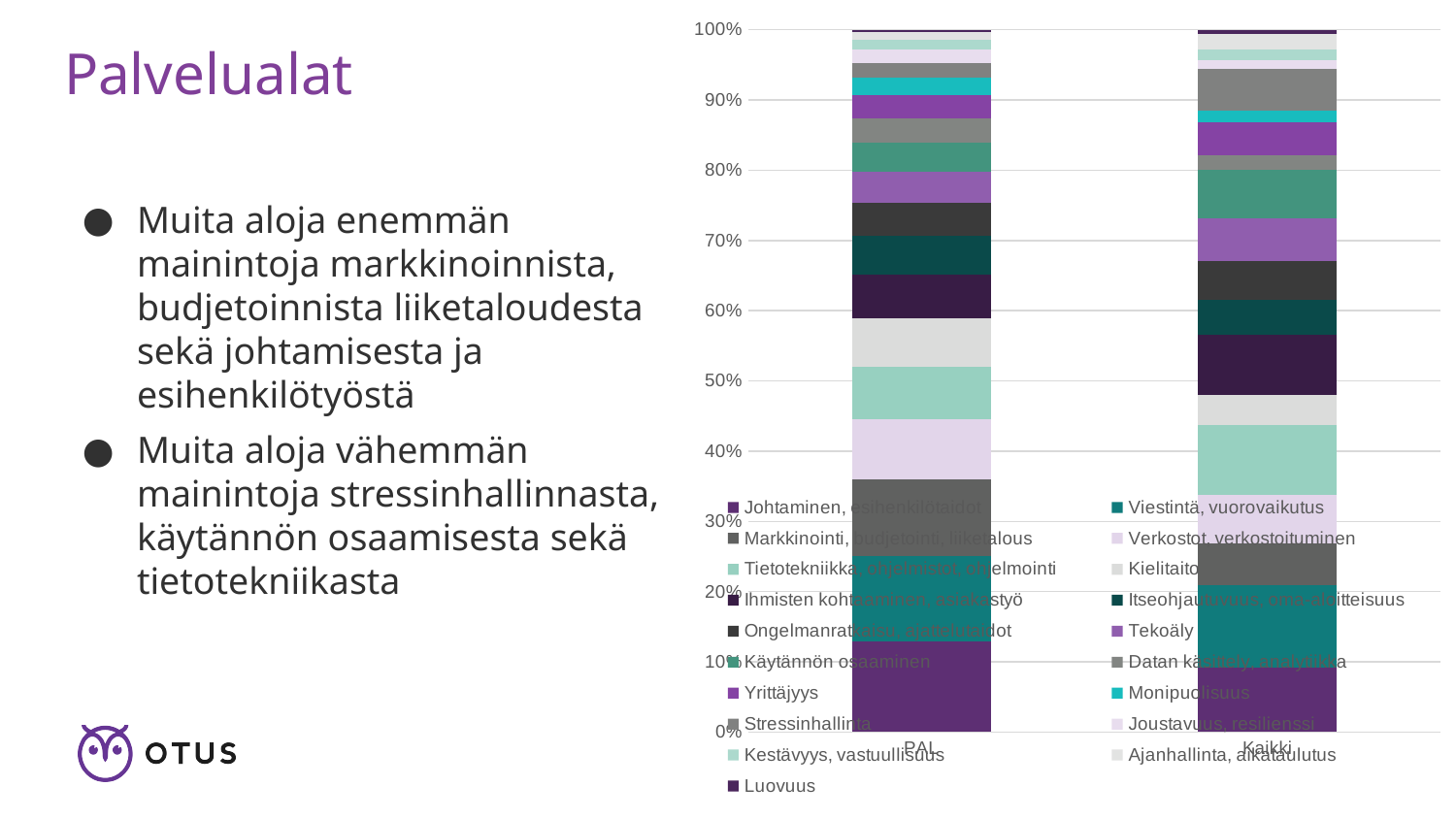
What is the total height of the PAL stacked bar? 100% What is the total height of the Kaikki stacked bar? 100% What kind of chart is shown on the slide? Stacked bar chart How many series does the chart's legend list? 19 How many bars are plotted in the chart? 2 Which bar has the taller bottom segment, PAL or Kaikki? PAL What are the two categories on the x axis of the chart? PAL and Kaikki Is the bottom segment of the PAL bar greater or less than 10%? greater What is the highest value shown on the y axis? 100%